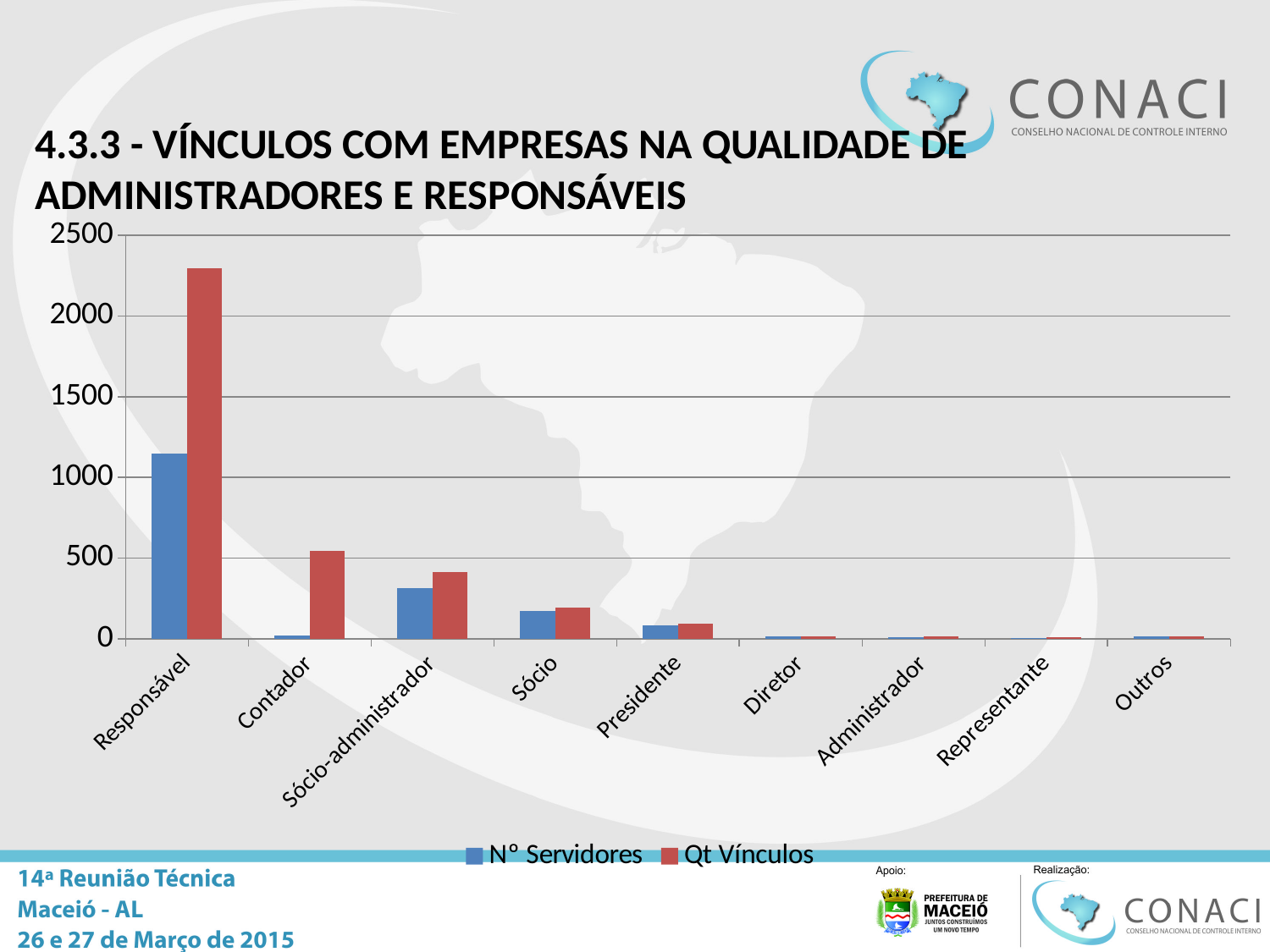
Is the Qt Vínculos value for Responsável greater or less than 2000? greater Which category has the highest Qt Vínculos value? Responsável Which category has the highest Nº Servidores value? Responsável For Contador, which series has the larger value, Nº Servidores or Qt Vínculos? Qt Vínculos What are the two series named in the chart's legend? Nº Servidores and Qt Vínculos How many series does the chart's legend list? 2 Do the Qt Vínculos values generally rise or fall from left to right across the categories? fall What kind of chart is shown on the slide? bar chart Is the Nº Servidores value for Responsável greater or less than 1000? greater How many categories are shown on the x axis of the chart? 9 Is the Nº Servidores value for Contador greater or less than 500? less